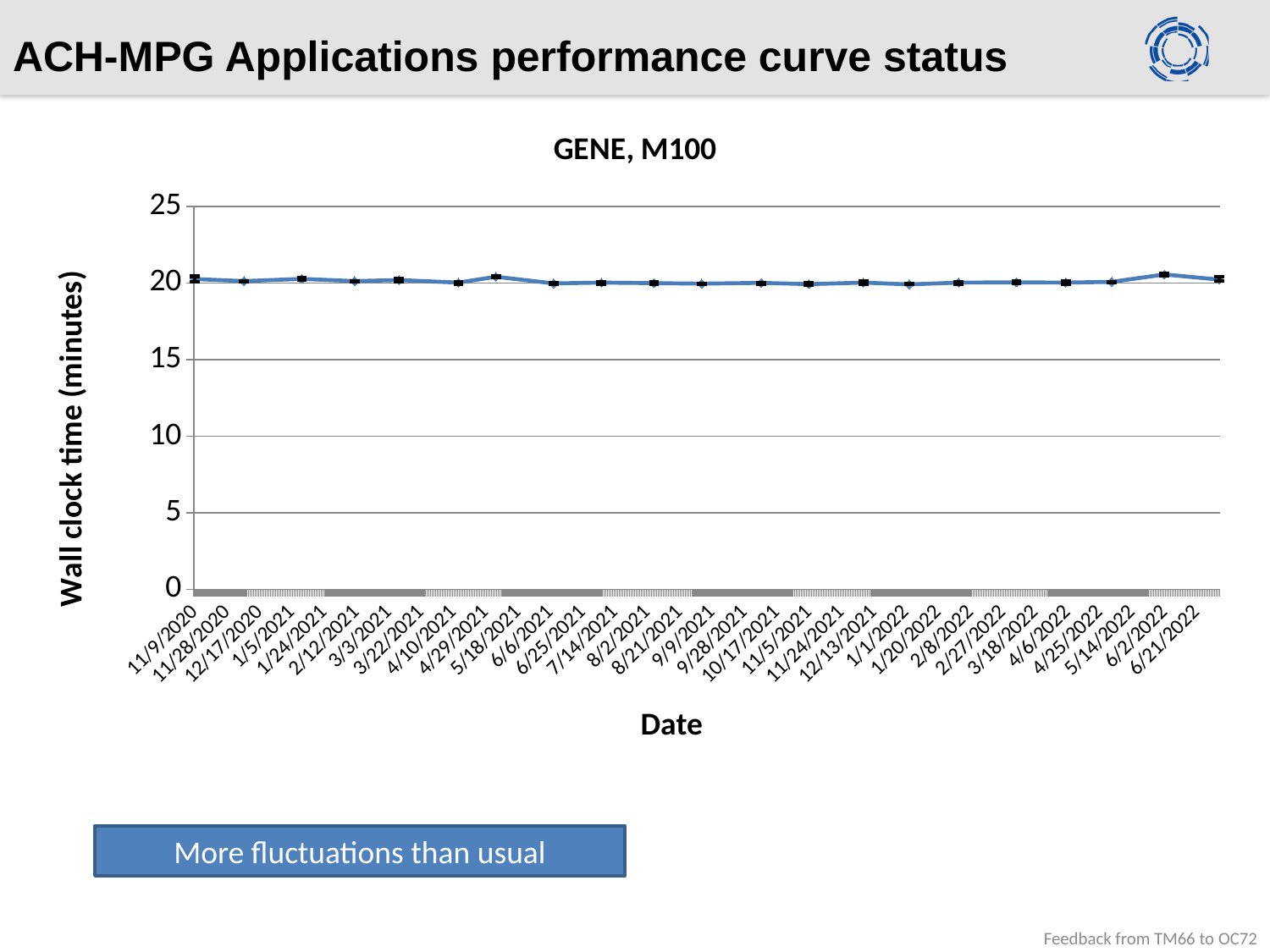
Is the value for 11/9/2020 greater or less than 15? greater What kind of chart is shown on the slide? line chart Is the value for 3/3/2021 greater or less than 25? less What is the highest value shown on the vertical axis? 25 Is the value for 6/21/2022 greater or less than 25? less What is the label of the vertical axis of the chart? Wall clock time (minutes) Do the values rise, fall, or stay roughly flat along the x axis? roughly flat What is the title of the chart? GENE, M100